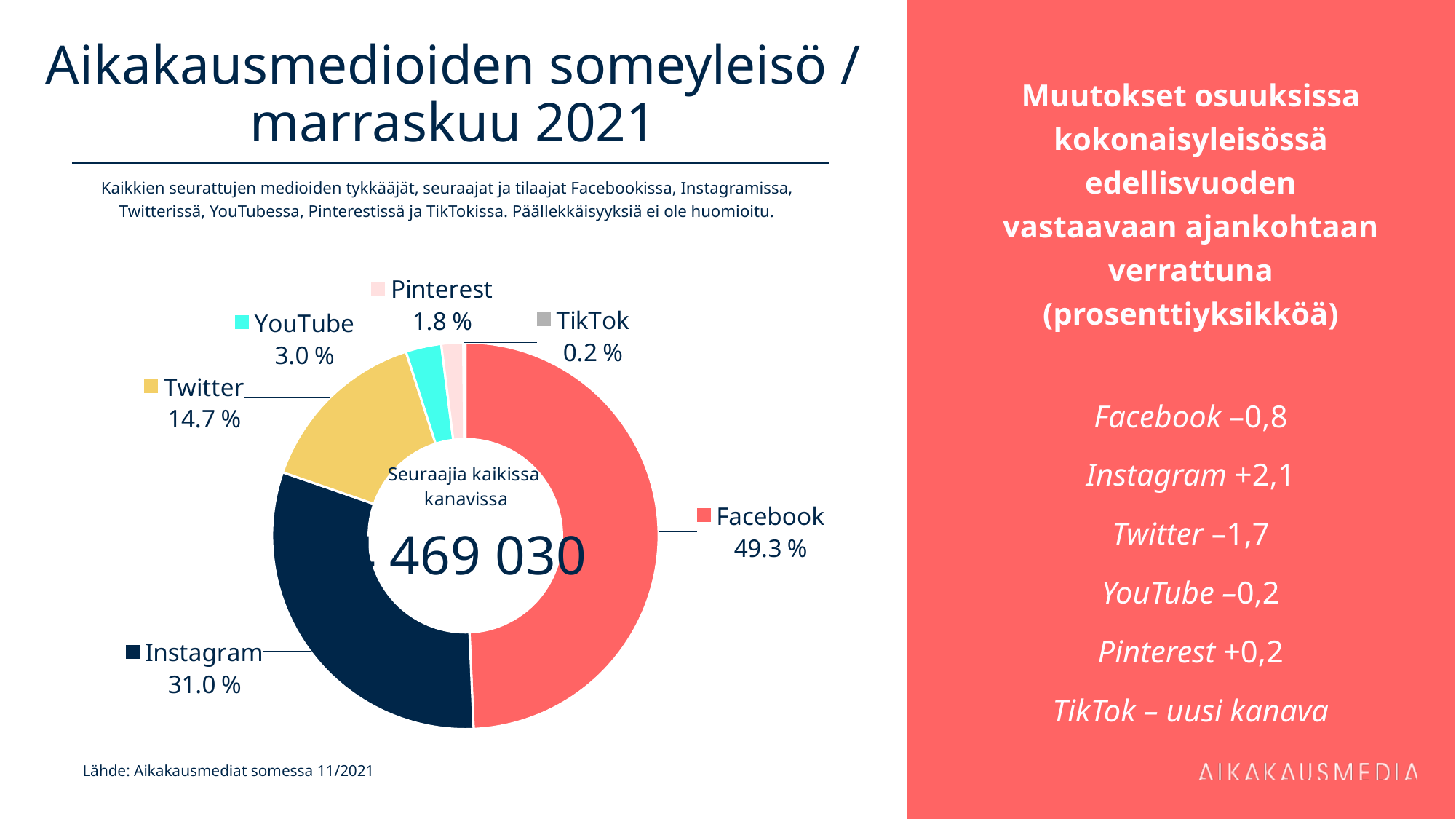
Which has a larger share, Twitter or YouTube? Twitter What share of the social media audience does YouTube hold? 3.0 % What colour is the Twitter slice in the chart? Yellow What type of chart is shown on the slide? Pie (donut) chart What share of the social media audience does Facebook hold? 49.3 % How many percentage points larger is Facebook's share than Instagram's share? 18.3 What share of the social media audience does Instagram hold? 31.0 % What share of the social media audience does Pinterest hold? 1.8 % What share of the social media audience does Twitter hold? 14.7 % How many channels are shown in the chart? 6 Which channel has the smallest share of the audience? TikTok Which channel has the largest share of the audience? Facebook